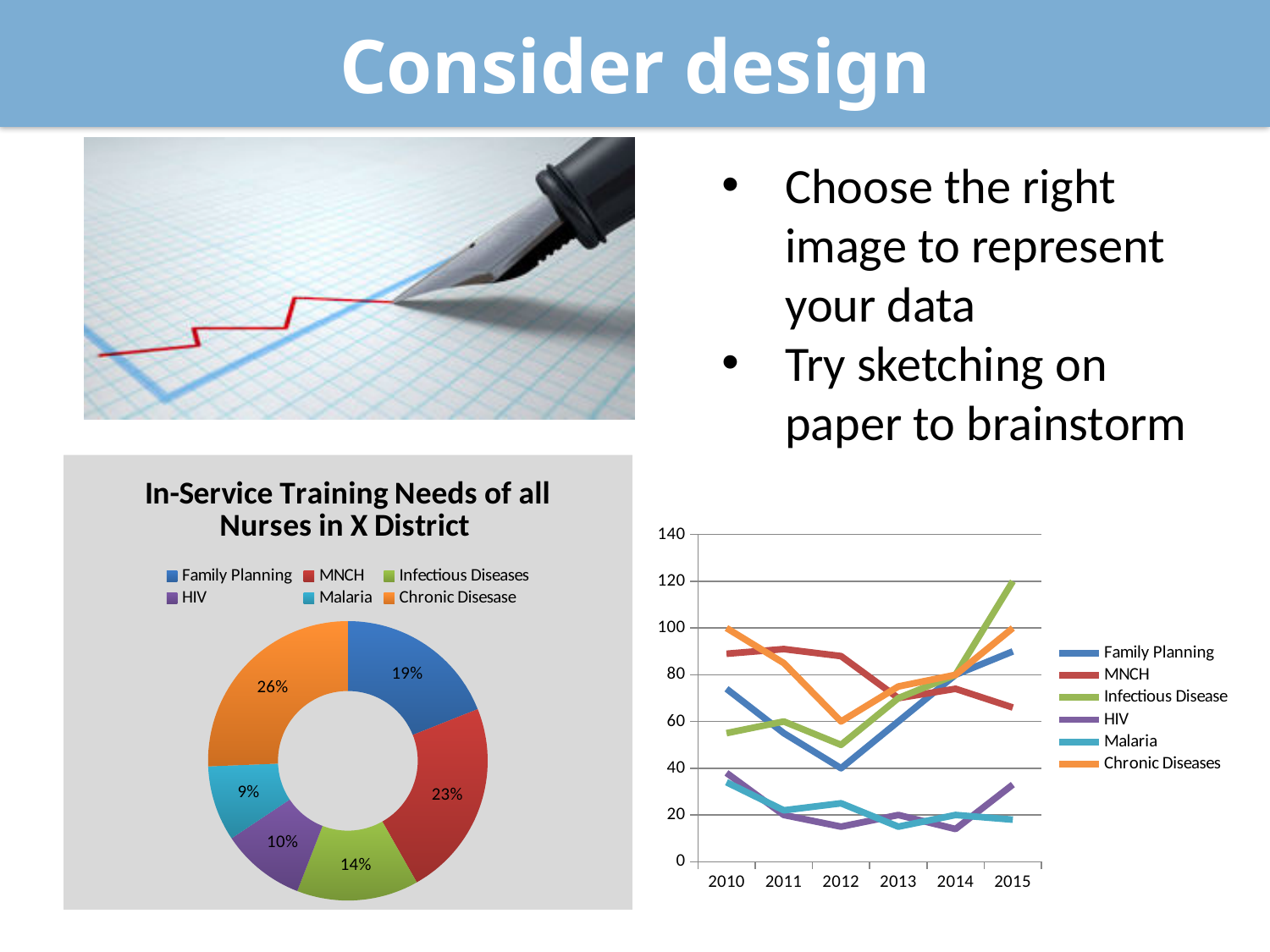
What kind of chart is the 'In-Service Training Needs of all Nurses in X District' chart? Doughnut chart What kind of chart is the chart on the bottom right of the slide? Line chart In the line chart on the bottom right, is the value for Infectious Disease in 2015 greater or less than 100? greater In the 'In-Service Training Needs of all Nurses in X District' chart, what is the difference between the MNCH share and the Family Planning share? 4% In the 'In-Service Training Needs of all Nurses in X District' chart, what share is shown for MNCH? 23% In the 'In-Service Training Needs of all Nurses in X District' chart, which category has the smallest share? Malaria In the 'In-Service Training Needs of all Nurses in X District' chart, which is larger, HIV or Infectious Diseases? Infectious Diseases How many series does the legend of the line chart on the bottom right list? 6 In the 'In-Service Training Needs of all Nurses in X District' chart, which category has the largest share? Chronic Disease In the 'In-Service Training Needs of all Nurses in X District' chart, what share is shown for Chronic Disease? 26% How many categories does the 'In-Service Training Needs of all Nurses in X District' chart show? 6 In the line chart on the bottom right, is the value for HIV in 2014 greater or less than 20? less